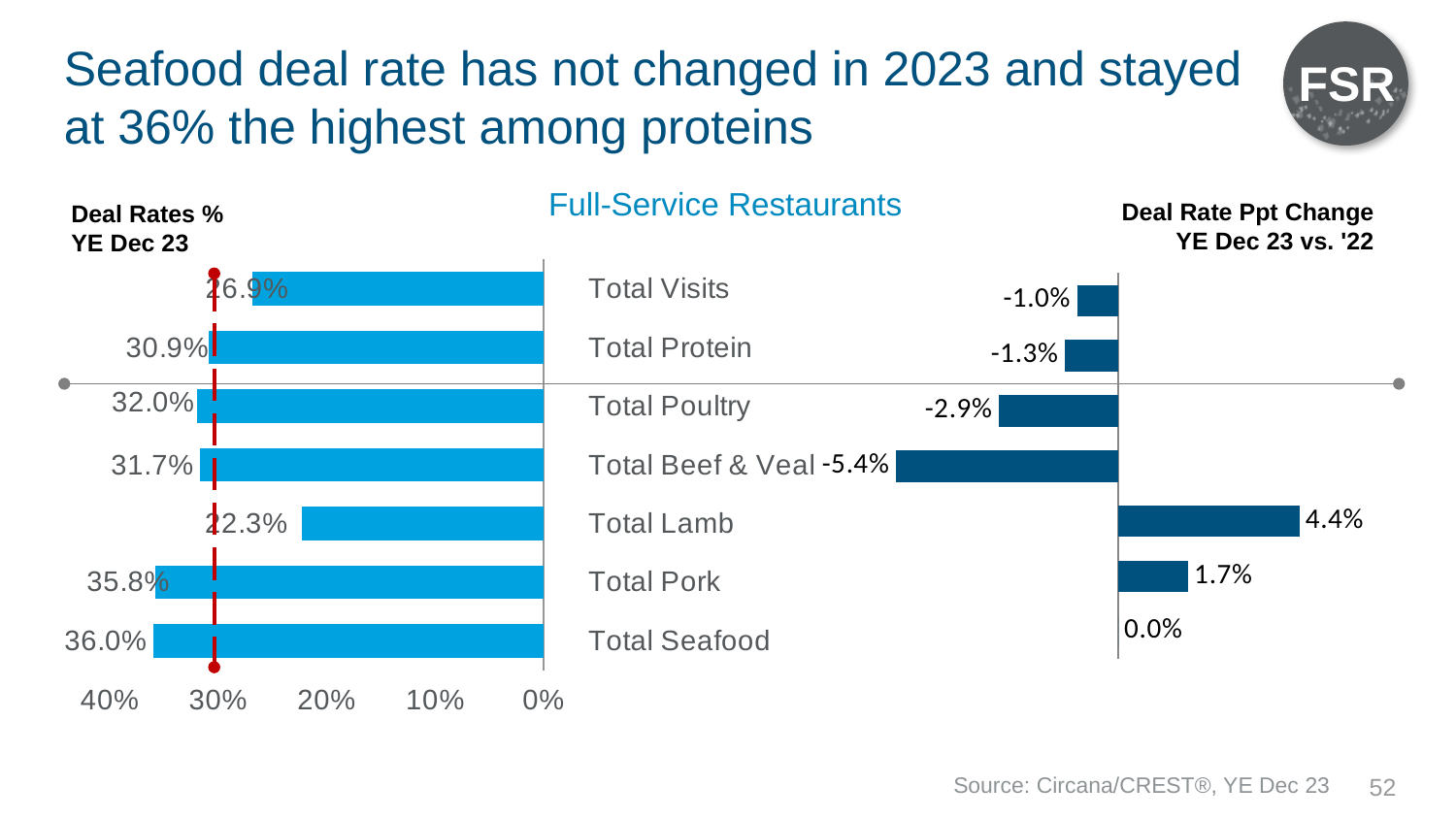
What type of chart is the Deal Rate Ppt Change YE Dec 23 vs. '22 chart? Bar chart In the Deal Rate Ppt Change YE Dec 23 vs. '22 chart, which category has the largest positive change? Total Lamb In the Deal Rates % YE Dec 23 chart, what is the value for Total Seafood? 36.0% In the Deal Rates % YE Dec 23 chart, which category has the lowest value? Total Lamb In the Deal Rates % YE Dec 23 chart, what is the value for Total Lamb? 22.3% In the Deal Rates % YE Dec 23 chart, what is the difference between Total Seafood and Total Pork? 0.2% In the Deal Rates % YE Dec 23 chart, which category has the highest value? Total Seafood In the Deal Rate Ppt Change YE Dec 23 vs. '22 chart, what is the value for Total Beef & Veal? -5.4% In the Deal Rate Ppt Change YE Dec 23 vs. '22 chart, which category has the lowest value? Total Beef & Veal How many categories are shown in the Deal Rates % YE Dec 23 chart? 7 In the Deal Rates % YE Dec 23 chart, which is larger, Total Poultry or Total Beef & Veal? Total Poultry In the Deal Rate Ppt Change YE Dec 23 vs. '22 chart, what is the value for Total Pork? 1.7%